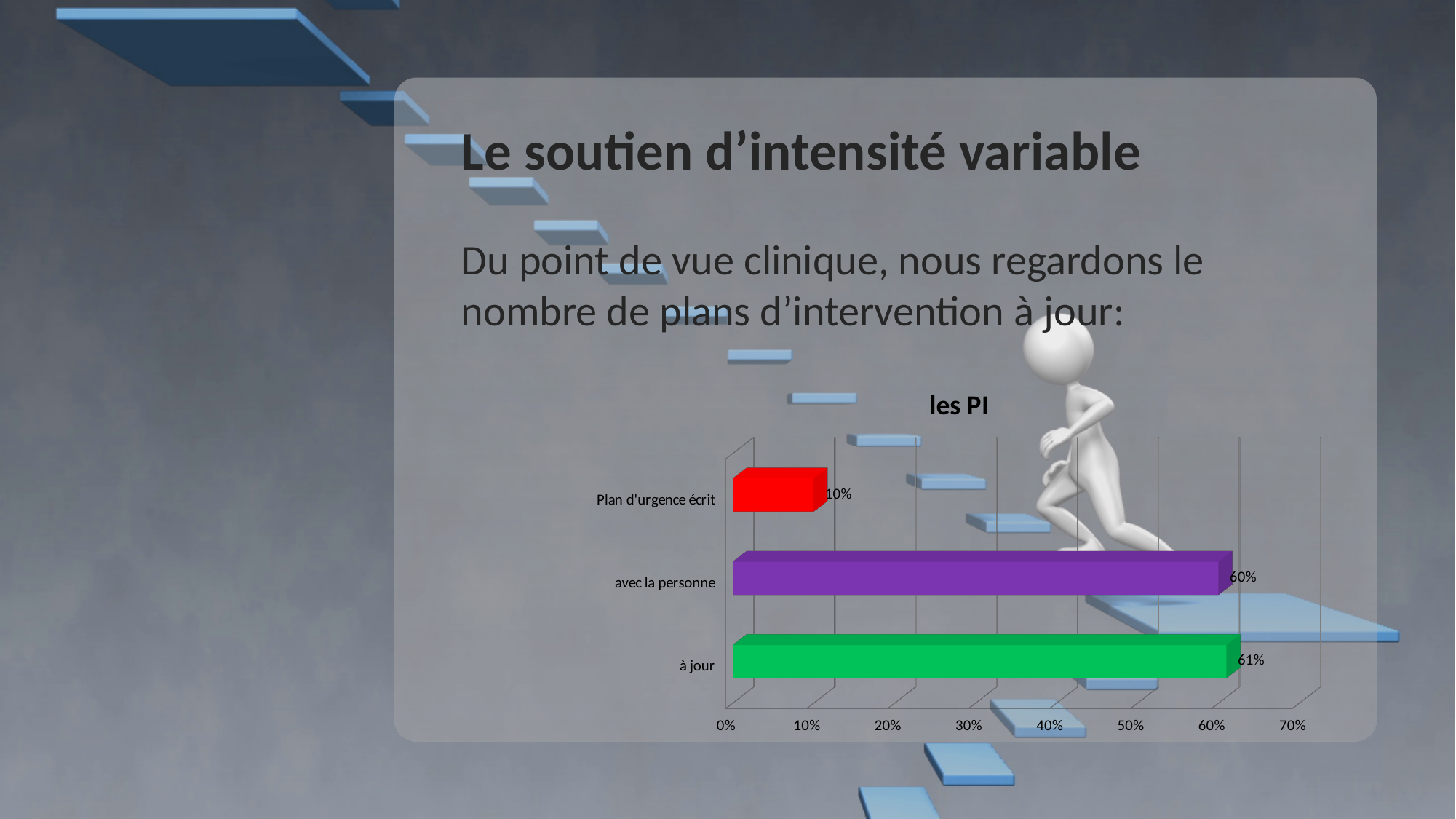
Is the value for "à jour" in the "les PI" chart greater or less than 50%? greater How many categories are shown in the "les PI" chart? 3 Which category has the lowest value in the "les PI" chart? Plan d'urgence écrit What kind of chart is the "les PI" chart? bar chart Which is larger in the "les PI" chart: the value for "avec la personne" or the value for "Plan d'urgence écrit"? avec la personne What is the value for "à jour" in the "les PI" chart? 61% Which category has the highest value in the "les PI" chart? à jour What is the value for "Plan d'urgence écrit" in the "les PI" chart? 10% What is the value for "avec la personne" in the "les PI" chart? 60% What is the difference between the values for "à jour" and "Plan d'urgence écrit" in the "les PI" chart? 51% What is the difference between the values for "avec la personne" and "Plan d'urgence écrit" in the "les PI" chart? 50% What is the title of the chart on the slide? les PI